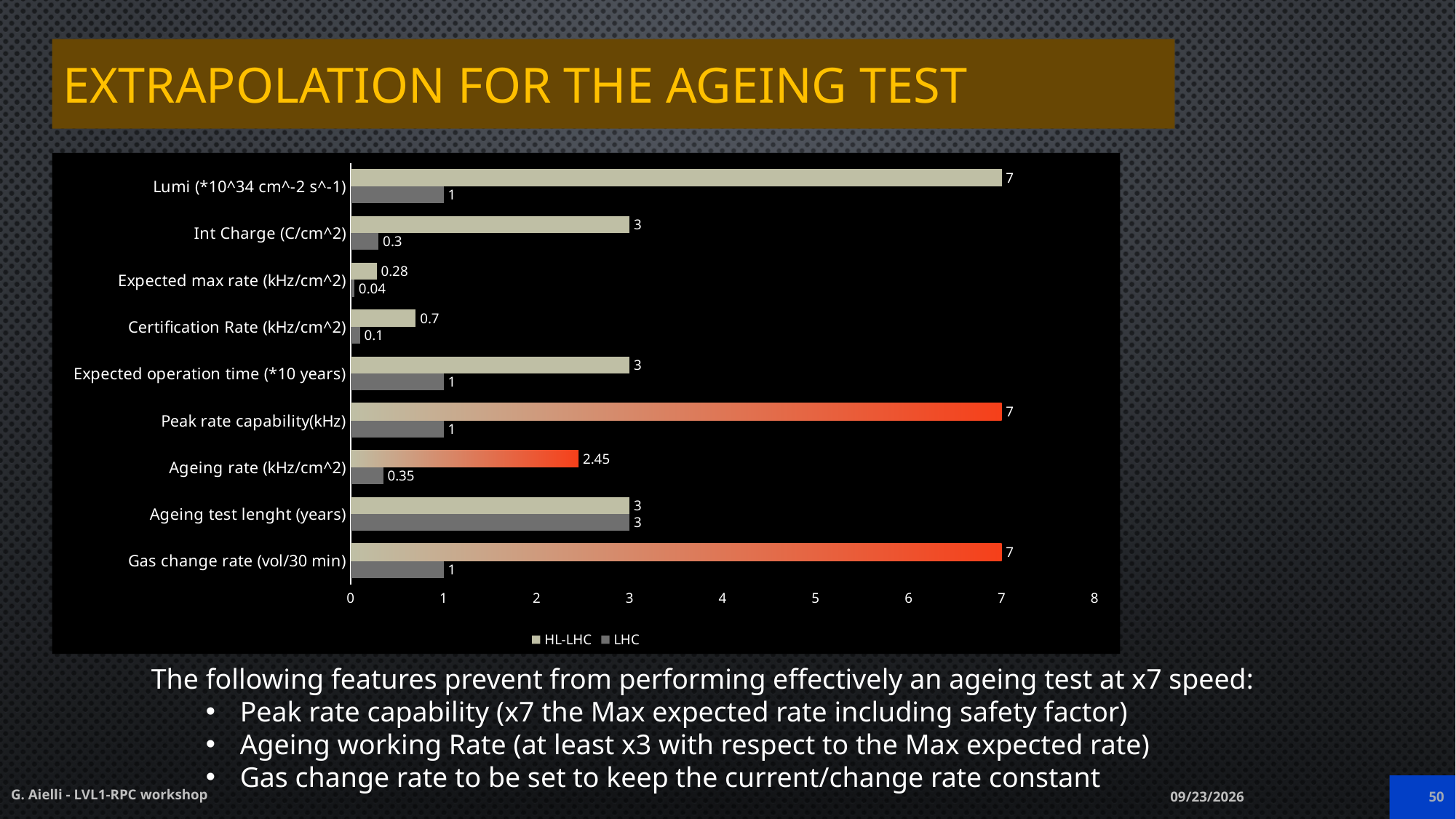
What is the HL-LHC value for Certification Rate (kHz/cm^2)? 0.7 What kind of chart is shown on the slide? Bar chart Which is larger for Gas change rate (vol/30 min), the HL-LHC value or the LHC value? HL-LHC For which category are the HL-LHC and LHC values equal? Ageing test lenght (years) What is the LHC value for Expected max rate (kHz/cm^2)? 0.04 What is the HL-LHC value for Ageing rate (kHz/cm^2)? 2.45 What is the LHC value for Int Charge (C/cm^2)? 0.3 What is the difference between the HL-LHC and LHC values for Lumi (*10^34 cm^-2 s^-1)? 6 Which category has the lowest LHC value? Expected max rate (kHz/cm^2) How many series does the legend list? 2 How many categories are shown on the chart? 9 What is the difference between the HL-LHC and LHC values for Ageing rate (kHz/cm^2)? 2.1